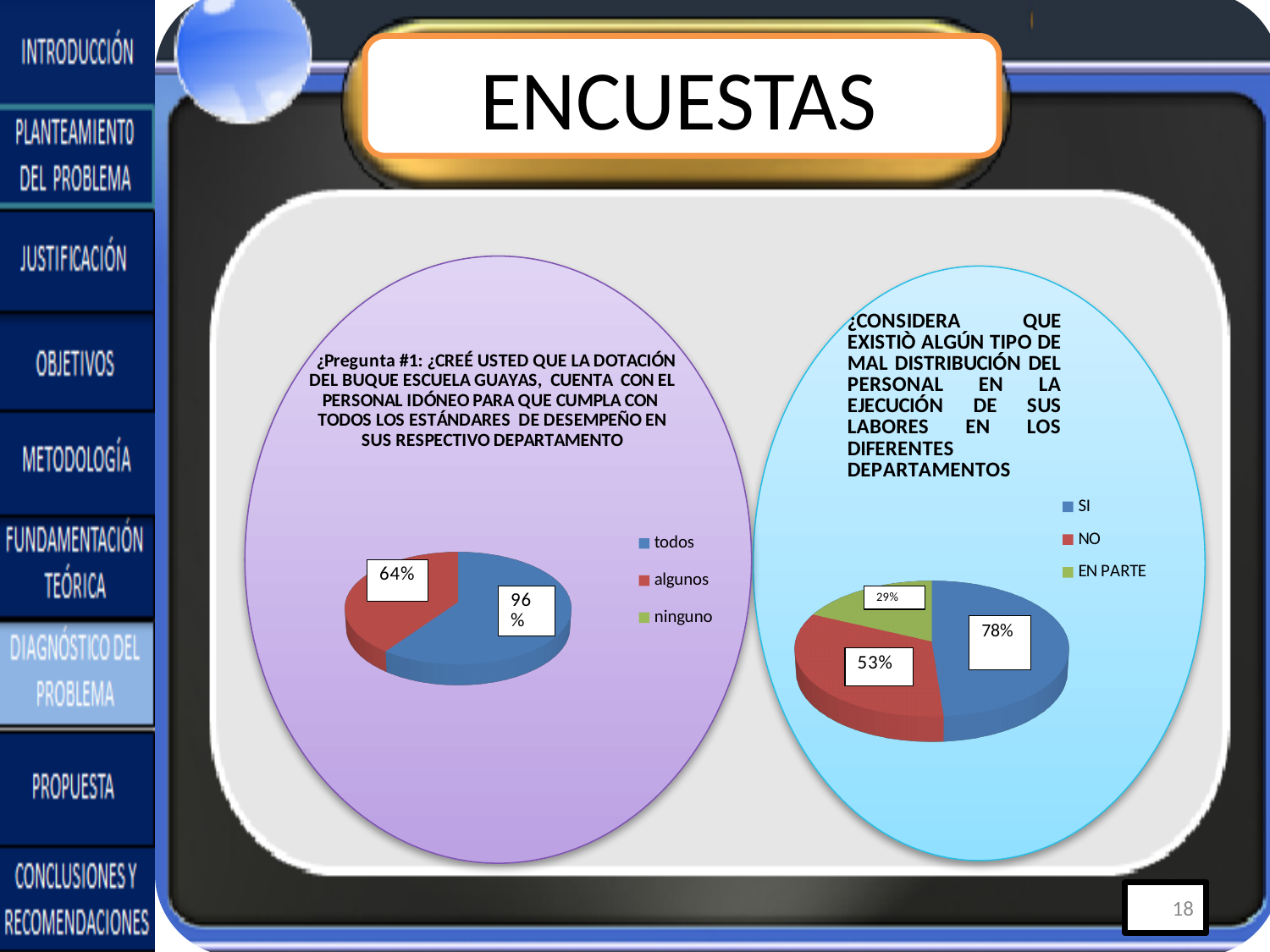
In the right chart, what percentage is shown for the 'SI' slice? 78% In the right chart, what is the difference between the percentages labelled for 'SI' and 'NO'? 25% How many entries does the legend of the right chart list? 3 In the left chart (Pregunta #1), what percentage is shown for the 'algunos' slice? 64% In the right chart, which category has the smallest slice? EN PARTE In the left chart (Pregunta #1), what percentage is shown for the 'todos' slice? 96% How many entries does the legend of the left chart (Pregunta #1) list? 3 In the right chart, what percentage is shown for the 'EN PARTE' slice? 29% In the right chart, what percentage is shown for the 'NO' slice? 53% In the right chart, which category has the largest slice? SI What kind of chart is the right chart on the slide? Pie chart What kind of chart is the left chart on the slide (Pregunta #1)? Pie chart